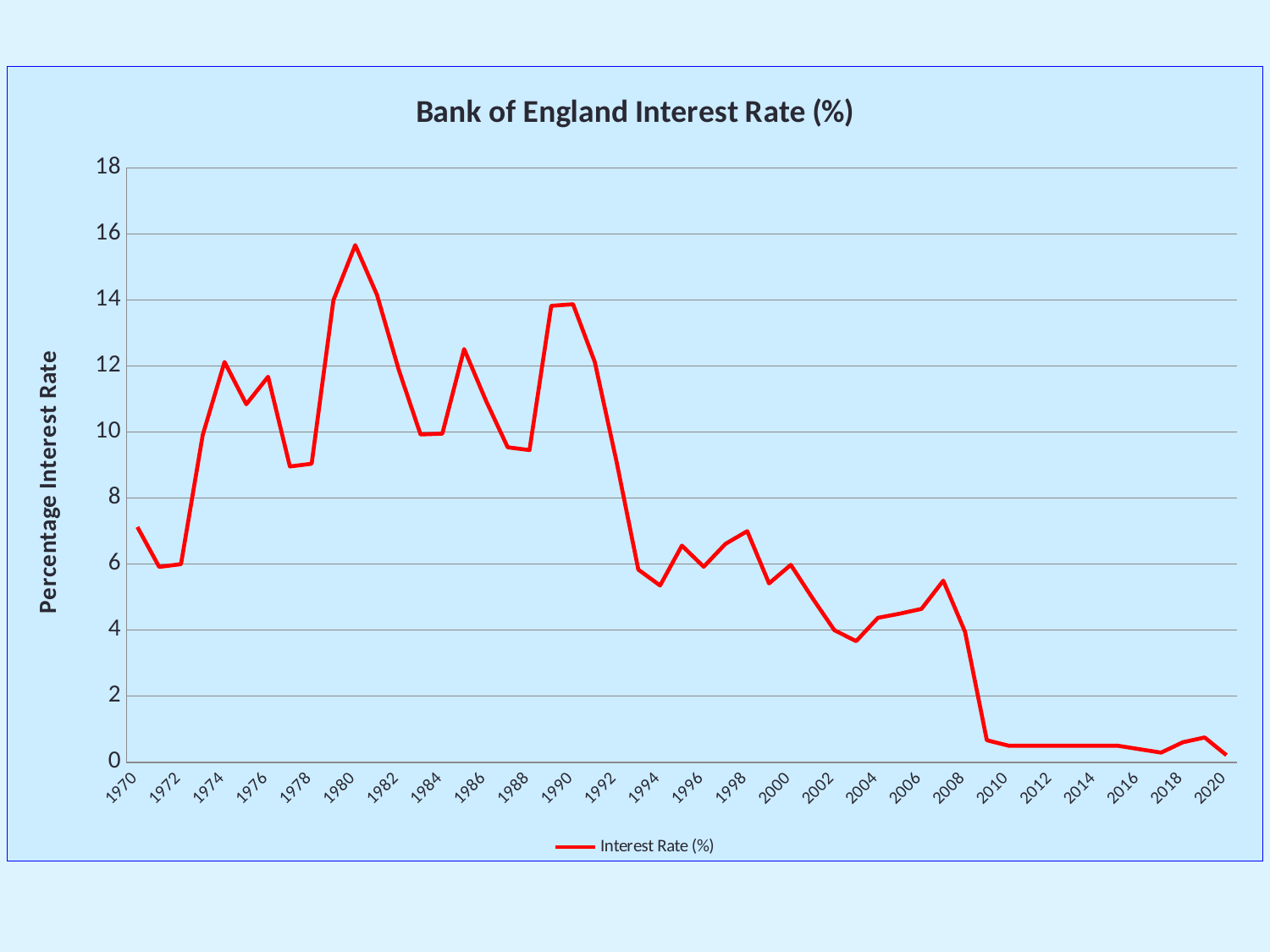
Is the interest rate in 2010 greater or less than 2? less What type of chart is shown on the slide? Line chart Which year has the higher interest rate, 1980 or 1990? 1980 Is the interest rate in 1972 greater or less than 8? less How many series does the legend list? 1 What is the label on the vertical axis? Percentage Interest Rate What is the title of the chart? Bank of England Interest Rate (%) Does the interest rate overall rise or fall between 1990 and 2020? Fall Is the interest rate in 1990 greater or less than 12? greater In which year does the interest rate reach its highest value? 1980 Which year has the higher interest rate, 2000 or 2010? 2000